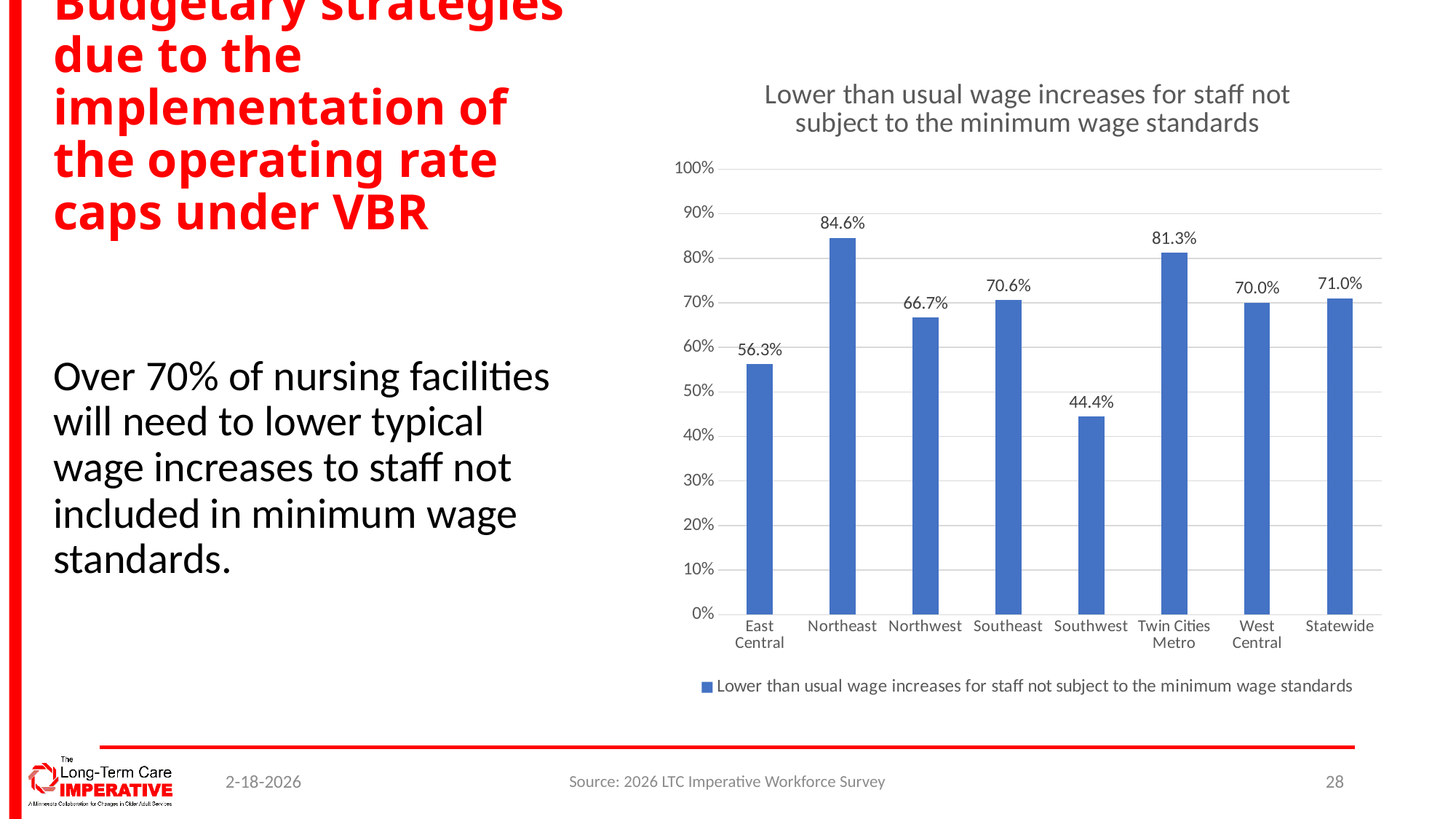
Is the value for East Central greater or less than 60%? less How many regions are shown on the x axis? 8 What is the title of the chart? Lower than usual wage increases for staff not subject to the minimum wage standards What is the difference between the Northeast and East Central values? 28.3% What is the Statewide value? 71.0% What is the value for Twin Cities Metro? 81.3% What kind of chart is shown on the slide? bar chart What is the value for Southwest? 44.4% Which region has the lowest value? Southwest Which region has the highest value? Northeast Which is larger, the value for Southeast or the value for Northwest? Southeast What is the value for Northeast? 84.6%